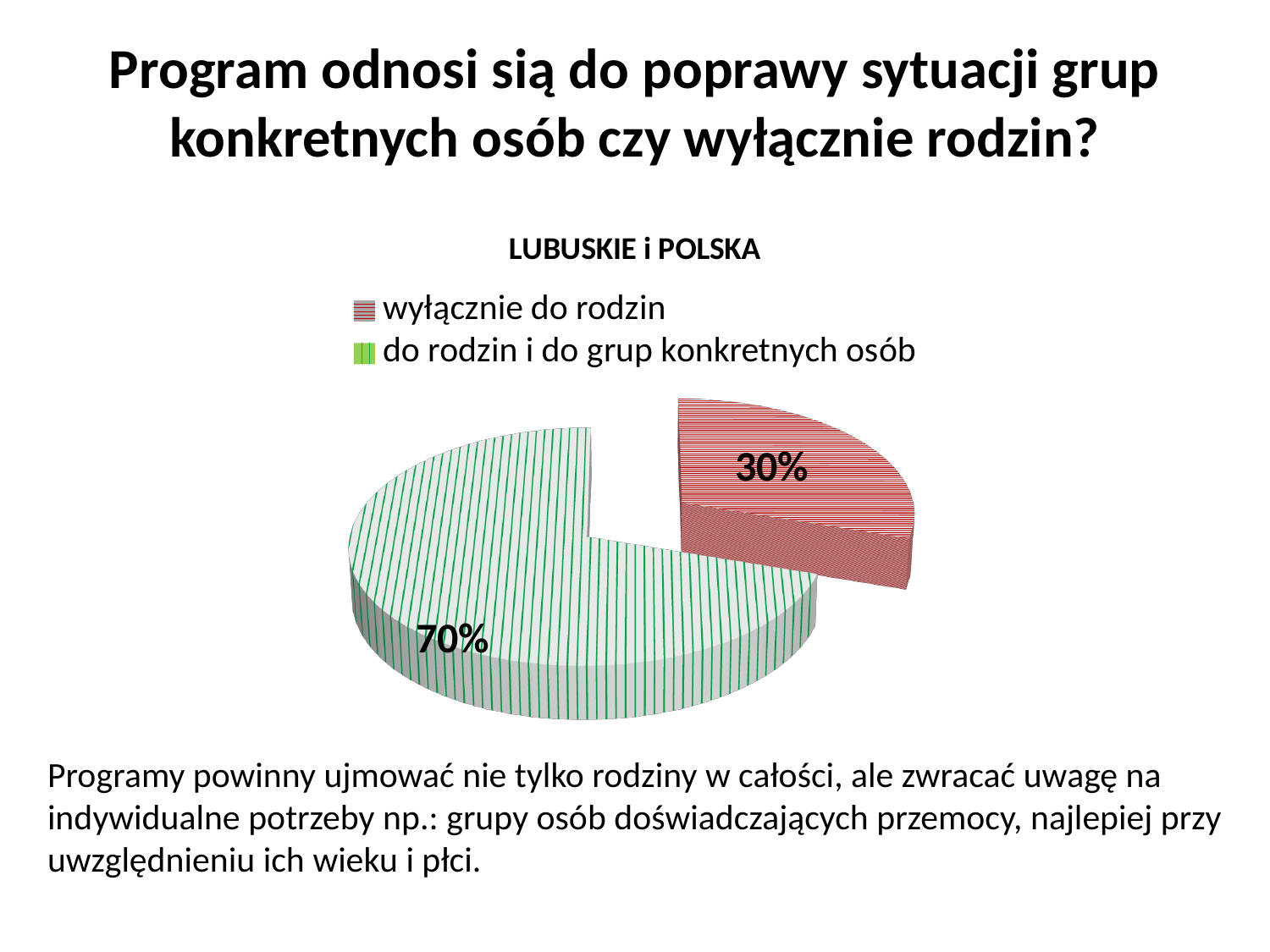
What is the title of the chart? LUBUSKIE i POLSKA What kind of chart is shown on the slide? pie chart Which category has the largest share of the pie? do rodzin i do grup konkretnych osób Which category has the smallest share of the pie? wyłącznie do rodzin What is the combined share of the two slices in the pie chart? 100% What share of the pie is labelled "wyłącznie do rodzin"? 30% What is the difference in percentage points between the "do rodzin i do grup konkretnych osób" slice and the "wyłącznie do rodzin" slice? 40 percentage points What share of the pie is labelled "do rodzin i do grup konkretnych osób"? 70% Which legend entry is shown with green stripes? do rodzin i do grup konkretnych osób How many slices does the pie chart have? 2 Which is larger: the share for "wyłącznie do rodzin" or the share for "do rodzin i do grup konkretnych osób"? do rodzin i do grup konkretnych osób How many entries does the legend list? 2